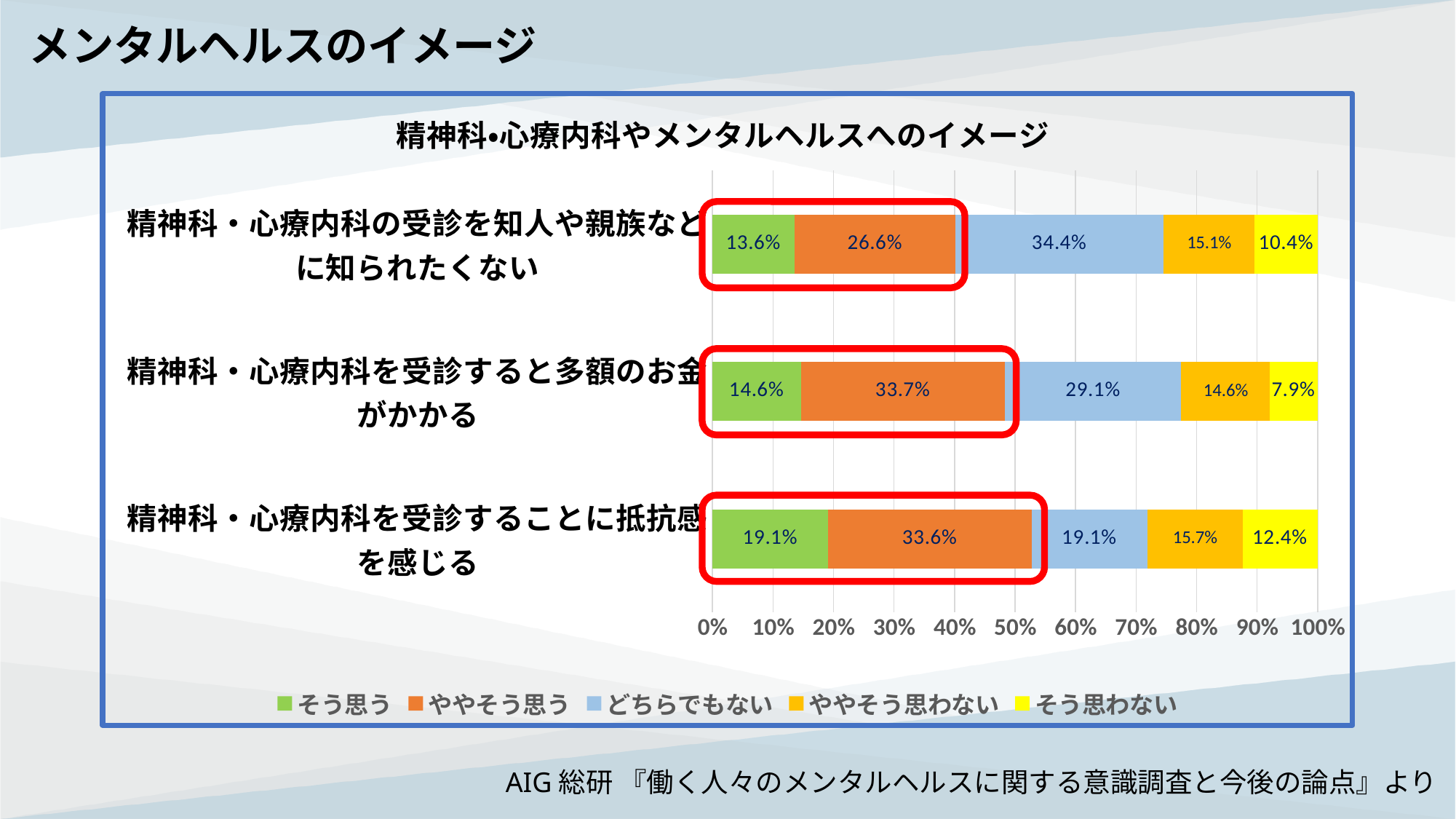
What is the difference between the ややそう思う values for 精神科・心療内科を受診すると多額のお金がかかる and 精神科・心療内科の受診を知人や親族などに知られたくない? 7.1% Which statement has the lowest そう思わない value? 精神科・心療内科を受診すると多額のお金がかかる Which is larger: the どちらでもない value for 精神科・心療内科の受診を知人や親族などに知られたくない or for 精神科・心療内科を受診することに抵抗感を感じる? 精神科・心療内科の受診を知人や親族などに知られたくない What is the value of そう思う for 精神科・心療内科を受診することに抵抗感を感じる? 19.1% What is the value of ややそう思う for 精神科・心療内科を受診すると多額のお金がかかる? 33.7% What type of chart is shown on the slide? Stacked bar chart How many categories (statements) are plotted in the chart? 3 What is the value of そう思わない for 精神科・心療内科を受診すると多額のお金がかかる? 7.9% What is the combined total of そう思う and ややそう思う for 精神科・心療内科の受診を知人や親族などに知られたくない? 40.2% Which statement has the highest そう思う value? 精神科・心療内科を受診することに抵抗感を感じる How many series does the legend list? 5 What is the value of どちらでもない for 精神科・心療内科の受診を知人や親族などに知られたくない? 34.4%